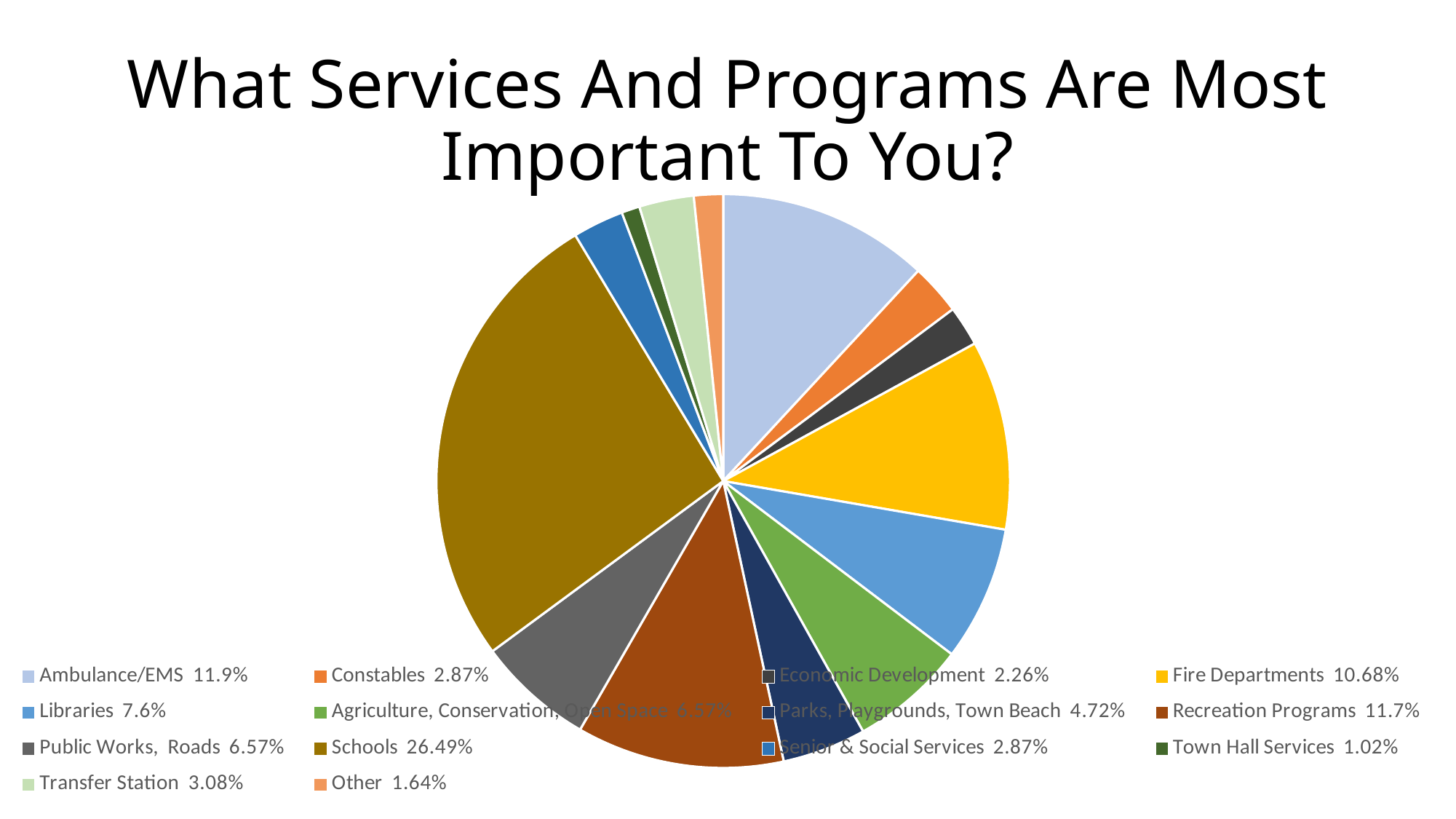
What is the difference between the values for Schools and Recreation Programs? 14.79% What is the value shown for Transfer Station? 3.08% What is the title of the chart? What Services And Programs Are Most Important To You? What is the value shown for Fire Departments? 10.68% What kind of chart is shown on the slide? pie chart How many categories does the pie chart have? 14 What share of the pie does Schools account for? 26.49% What is the value shown for Libraries? 7.6% Which category has the largest share of the pie? Schools What is the difference between the values for Ambulance/EMS and Fire Departments? 1.22% Which category has the smallest share of the pie? Town Hall Services Which is larger, Recreation Programs or Libraries? Recreation Programs